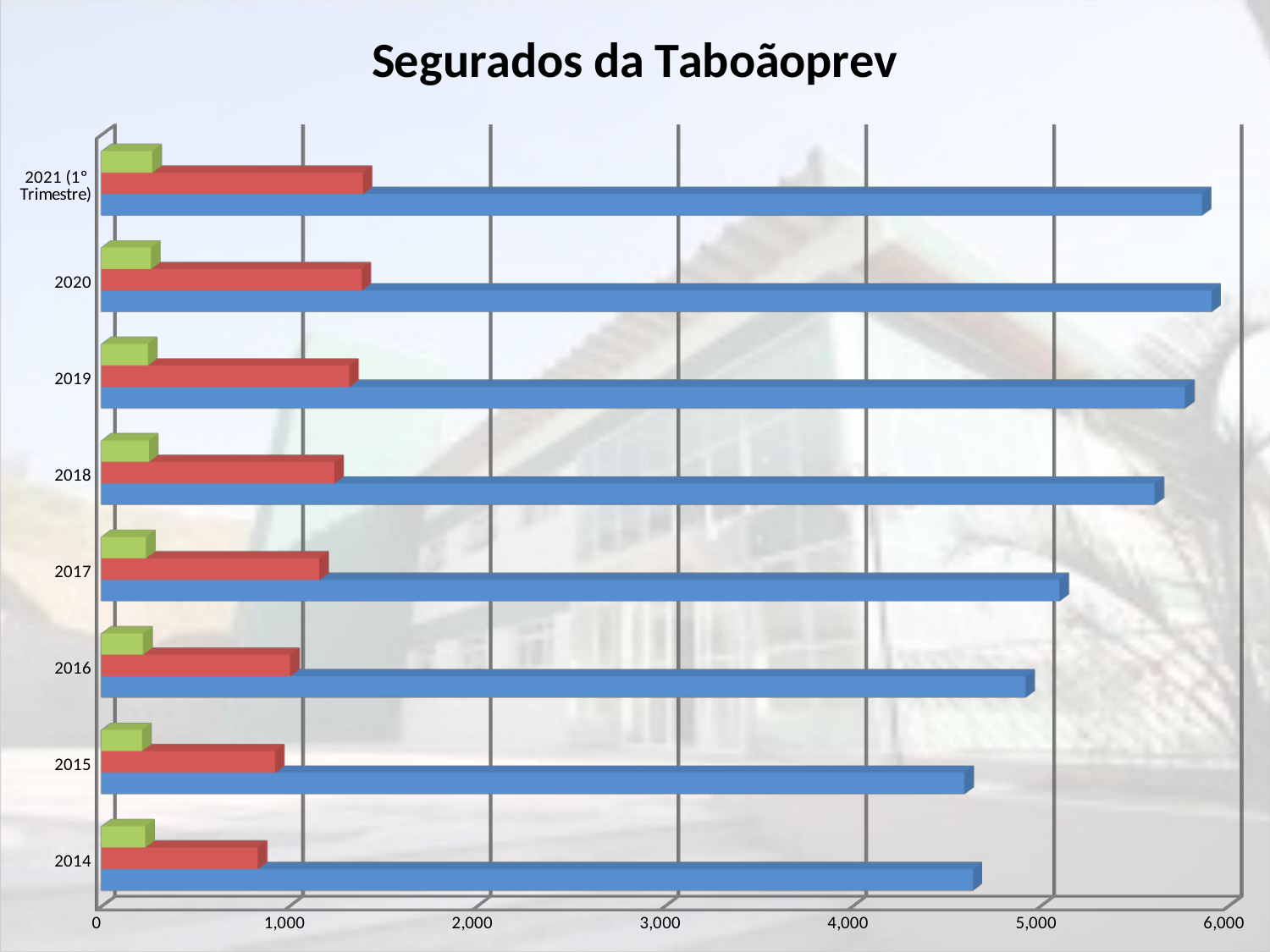
Is the value of the blue bar for 2015 greater or less than 5,000? less Do the blue bars generally rise or fall from 2014 to 2020? rise What is the title of the chart? Segurados da Taboãoprev What kind of chart is shown on the slide? bar chart Is the value of the blue bar for 2018 greater or less than 5,000? greater How many categories (years) are shown on the vertical axis? 8 Is the value of the blue bar for 2014 greater or less than 4,000? greater Which year has the shortest red bar? 2014 How many bar colours (series) are plotted for each year? 3 Which is larger, the blue bar for 2018 or the blue bar for 2016? 2018